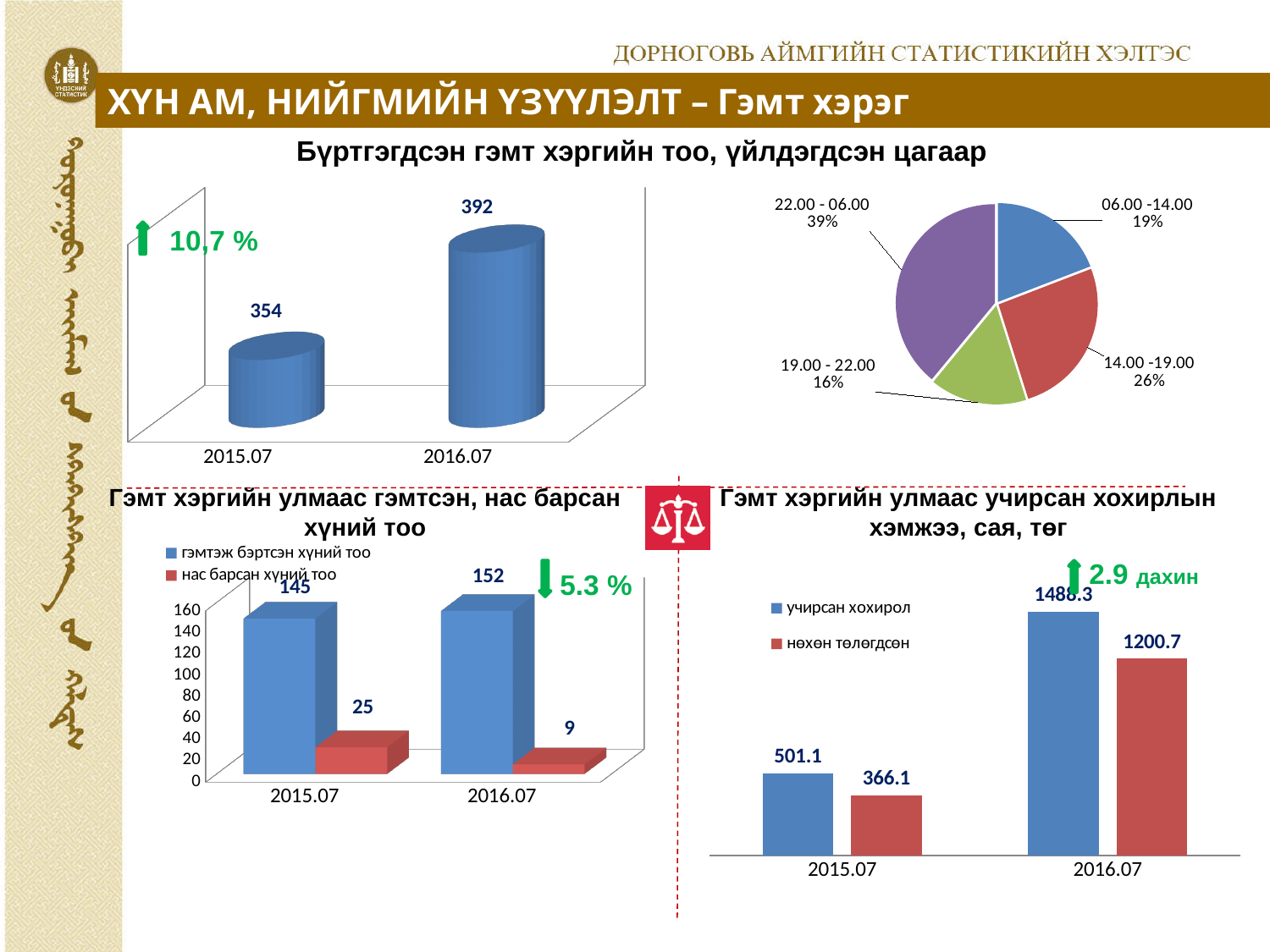
In the top-right pie chart, what share does the 22.00 - 06.00 slice have? 39% How many series does the legend of the bottom-left chart list? 2 In the bottom-left chart 'Гэмт хэргийн улмаас гэмтсэн, нас барсан хүний тоо', what is the value of 'нас барсан хүний тоо' for 2016.07? 9 In the top-right pie chart, which time period has the smallest share? 19.00 - 22.00 How many slices does the top-right pie chart have? 4 In the top-left bar chart, what is the value for 2015.07? 354 In the bottom-right chart, what is the value of 'учирсан хохирол' for 2015.07? 501.1 What kind of chart is the top-right chart on the slide? pie chart In the bottom-left chart, what is the value of 'гэмтэж бэртсэн хүний тоо' for 2015.07? 145 In the top-left bar chart, what is the difference between the 2016.07 and 2015.07 values? 38 In the bottom-right chart 'Гэмт хэргийн улмаас учирсан хохирлын хэмжээ, сая, төг', what is the value of 'нөхөн төлөгдсөн' for 2016.07? 1200.7 In the top-left bar chart 'Бүртгэгдсэн гэмт хэргийн тоо, үйлдэгдсэн цагаар', what is the value for 2016.07? 392